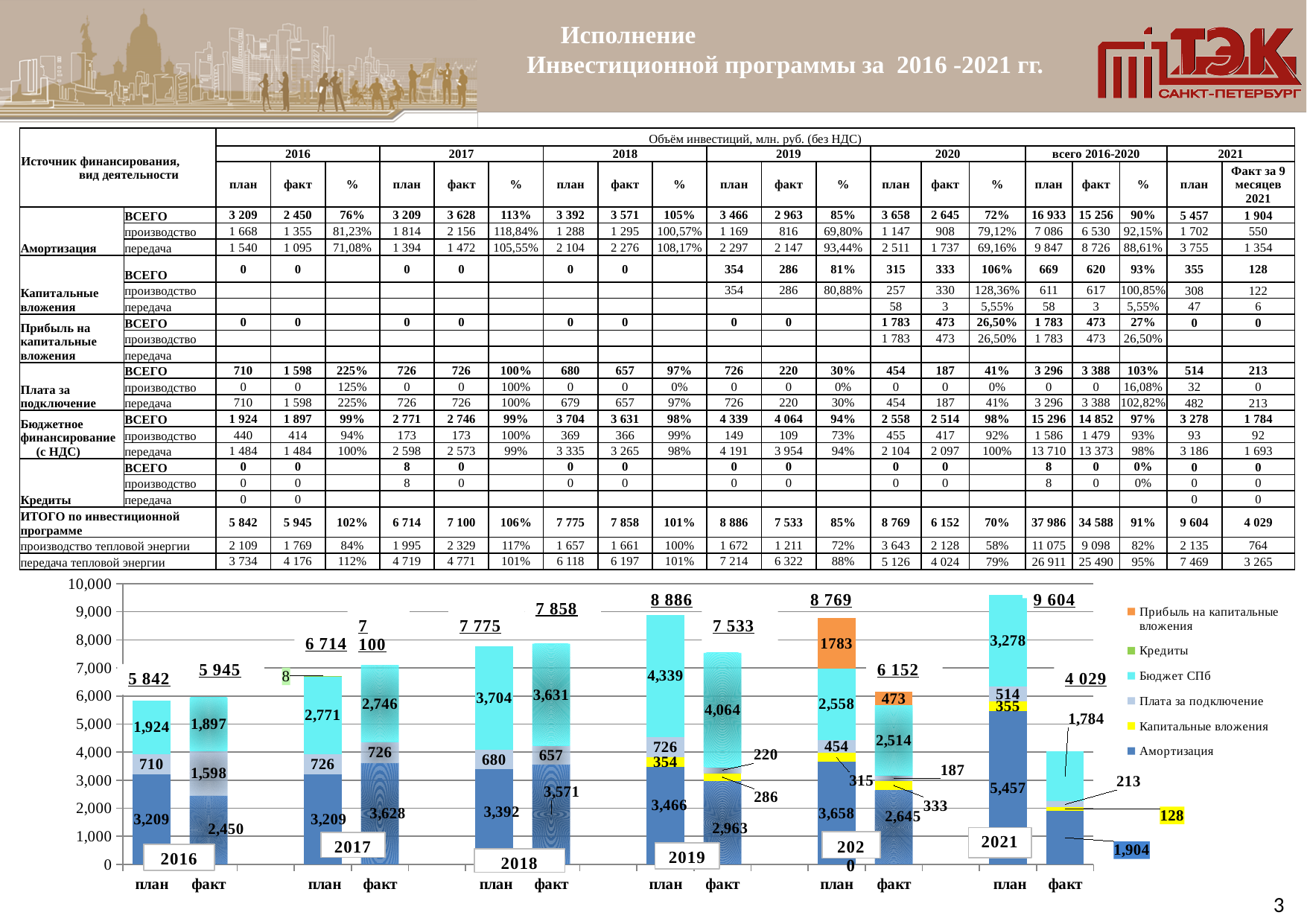
In the bar chart, which is larger: the Плата за подключение value for 2016 план or for 2016 факт? 2016 факт In the bar chart, what is the Амортизация value for the 2021 план bar? 5,457 In the bar chart, which bar has the lowest labelled total? 2021 факт How many bars are plotted in the bar chart? 12 In the bar chart, what is the Бюджет СПб value for the 2018 факт bar? 3,631 In the bar chart, what is the Прибыль на капитальные вложения value for the 2020 план bar? 1783 What kind of chart is shown at the bottom of the slide? stacked bar chart In the bar chart, what is the difference between the Амортизация values of the 2017 факт bar (3,628) and the 2017 план bar (3,209)? 419 In the bar chart, is the total of the 2020 факт bar greater or less than 7,000? less How many series does the legend of the bar chart list? 6 In the bar chart, which bar has the highest labelled total? 2021 план In the bar chart, what is the total labelled above the 2019 план bar? 8 886